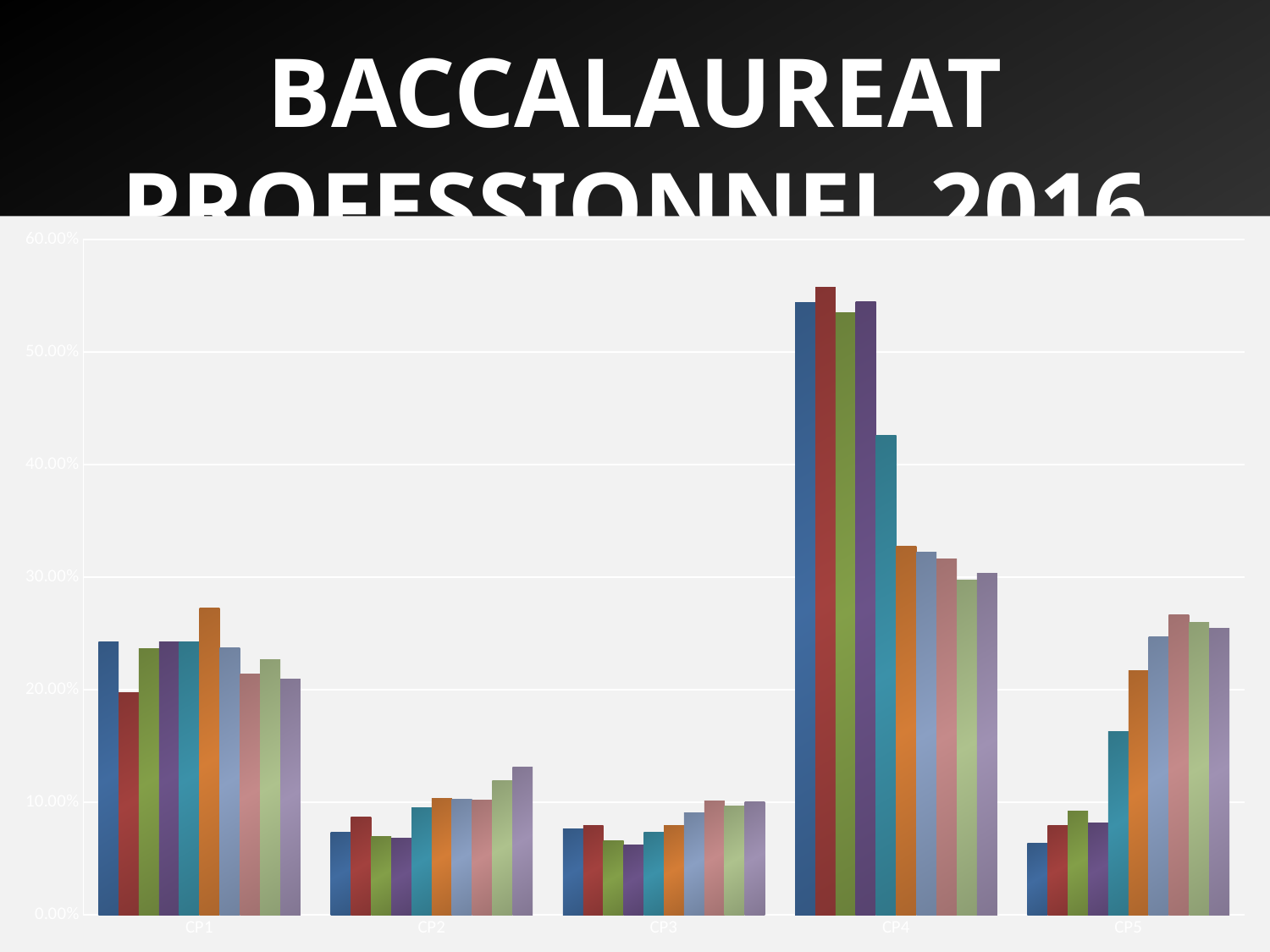
Is the value of the first (blue) bar for CP1 greater or less than 20%? greater What kind of chart is shown on the slide? bar chart What is the highest value shown on the y axis of the chart? 60.00% Is the value of the first (blue) bar for CP4 greater or less than 50%? greater Are all the bars for CP3 greater or less than 20%? less Which is larger, the first (blue) bar for CP1 or the first (blue) bar for CP2? CP1 How many categories are shown on the x axis of the chart? 5 What is the title of the slide containing the chart? BACCALAUREAT PROFESSIONNEL 2016 How many bars are plotted for the CP1 category? 10 Which category has the tallest bars in the chart? CP4